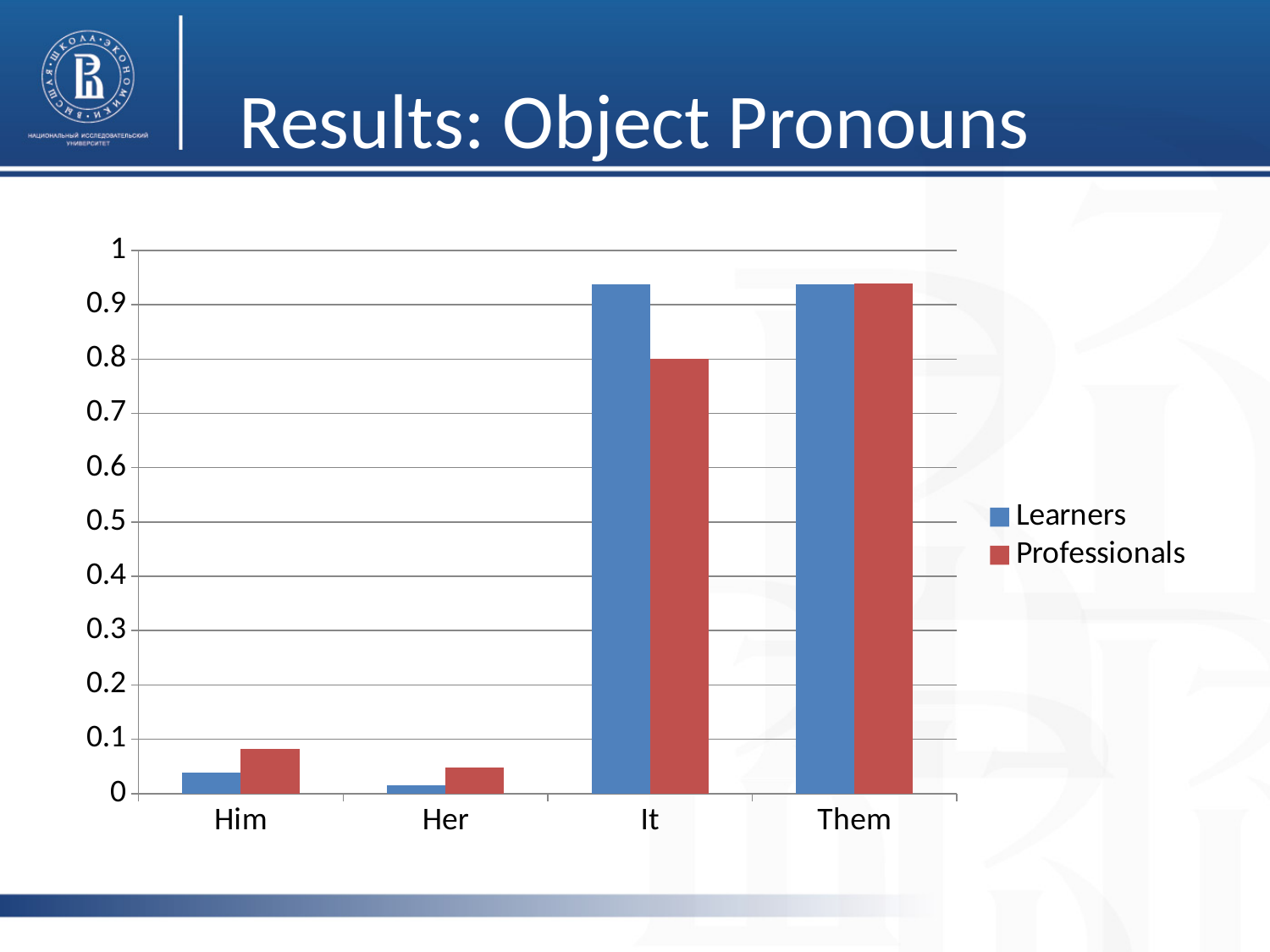
For Him, which series has the larger value, Learners or Professionals? Professionals How many series does the chart's legend list? 2 What is the Professionals value for It? 0.8 Which category has the lowest Learners value? Her Is the Learners value for Her greater or less than 0.1? less Is the Learners value for It greater or less than 0.9? greater Is the Professionals value for Him greater or less than 0.1? less What kind of chart is shown on the slide? bar chart Which category has the lowest Professionals value? Her What are the two series listed in the legend? Learners and Professionals For It, which series has the larger value, Learners or Professionals? Learners How many categories are shown on the x axis of the chart? 4